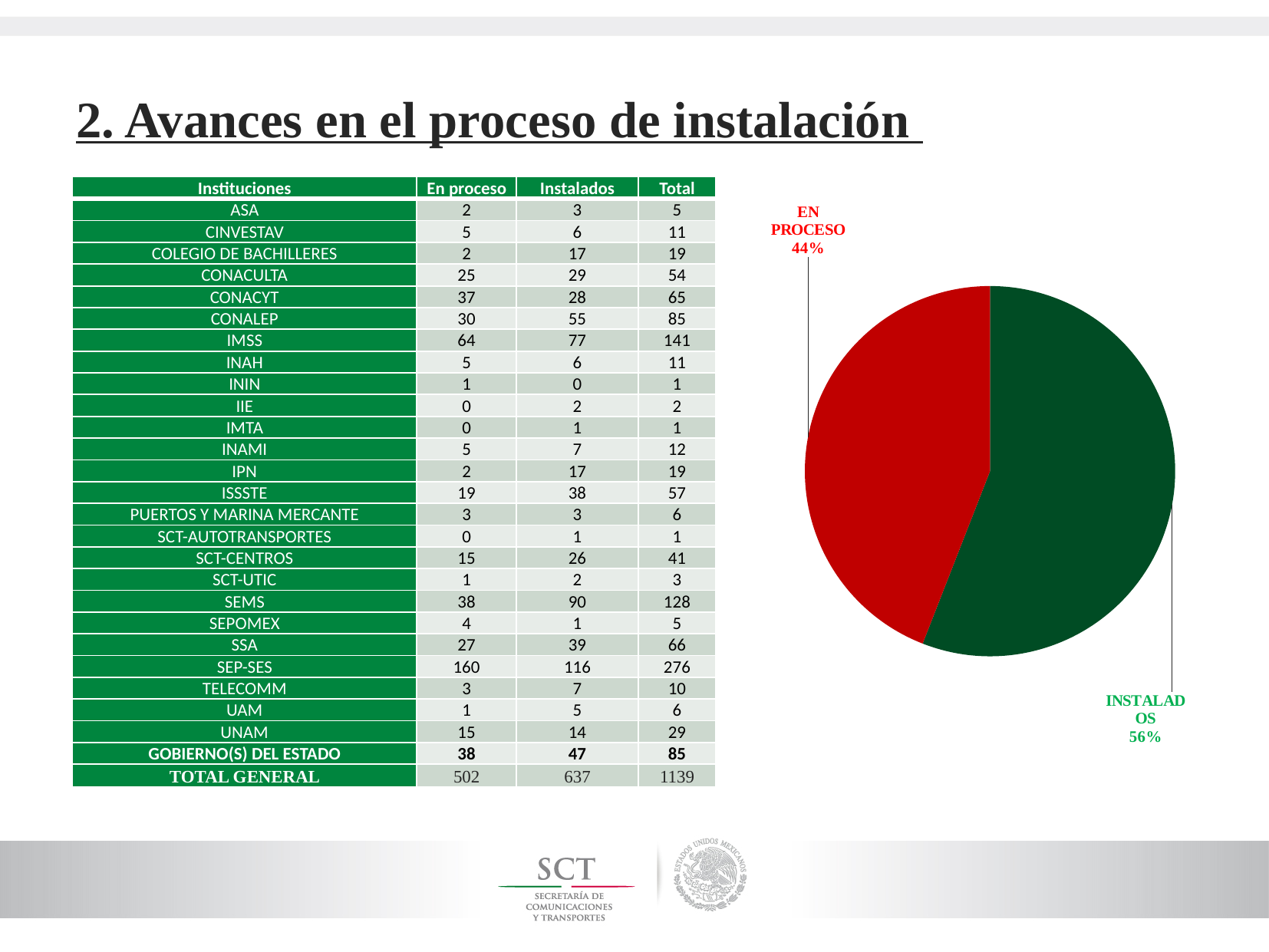
Is the INSTALADOS share in the pie chart greater or less than 50%? greater Which is larger in the pie chart, INSTALADOS or EN PROCESO? INSTALADOS What colour is the INSTALADOS slice in the pie chart? green What colour is the EN PROCESO slice in the pie chart? red By how many percentage points does the INSTALADOS share exceed the EN PROCESO share in the pie chart? 12 How many slices does the pie chart have? 2 What share of the pie chart does INSTALADOS represent? 56% What share of the pie chart does EN PROCESO represent? 44% What kind of chart is shown on the slide? pie chart Which slice of the pie chart is the smallest? EN PROCESO Which slice of the pie chart is the largest? INSTALADOS